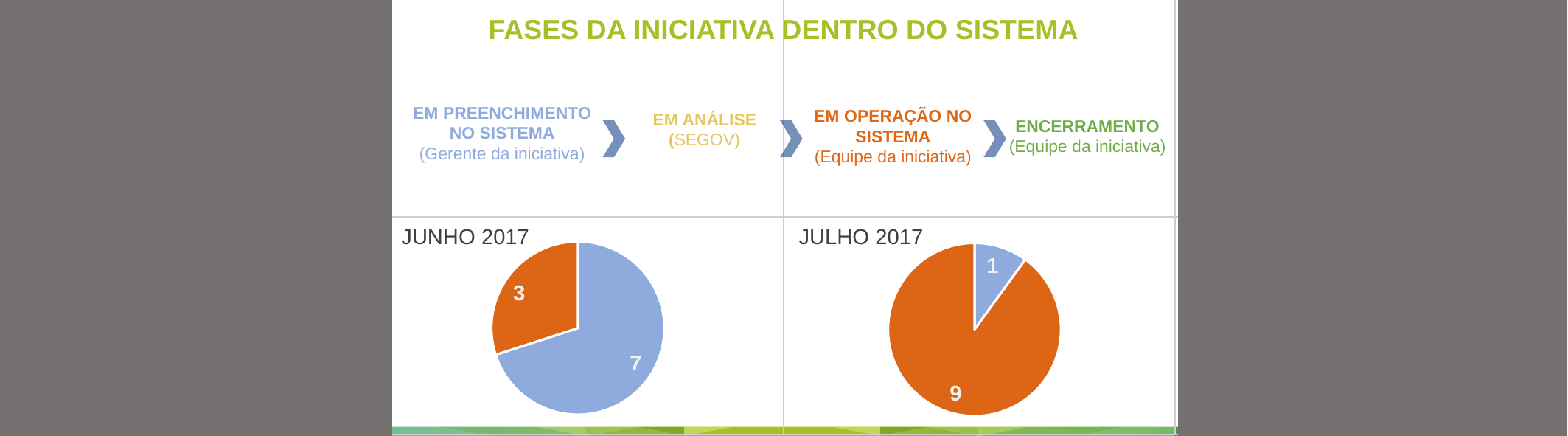
In the JUNHO 2017 pie chart, what is the value of the blue slice? 7 What is the title printed at the top of the slide above the charts? FASES DA INICIATIVA DENTRO DO SISTEMA In the JULHO 2017 pie chart, which slice is the largest? the orange slice (9) In the JUNHO 2017 pie chart, what is the value of the orange slice? 3 In the JULHO 2017 pie chart, what is the value of the blue slice? 1 In the JULHO 2017 pie chart, what share of the total does the orange slice represent? 90% How many slices does the JULHO 2017 pie chart have? 2 In the JUNHO 2017 pie chart, which slice is larger, the blue one or the orange one? the blue one In the JUNHO 2017 pie chart, what is the difference between the blue slice and the orange slice? 4 In the JULHO 2017 pie chart, what is the value of the orange slice? 9 What kind of chart is shown under JUNHO 2017? pie chart How many slices does the JUNHO 2017 pie chart have? 2